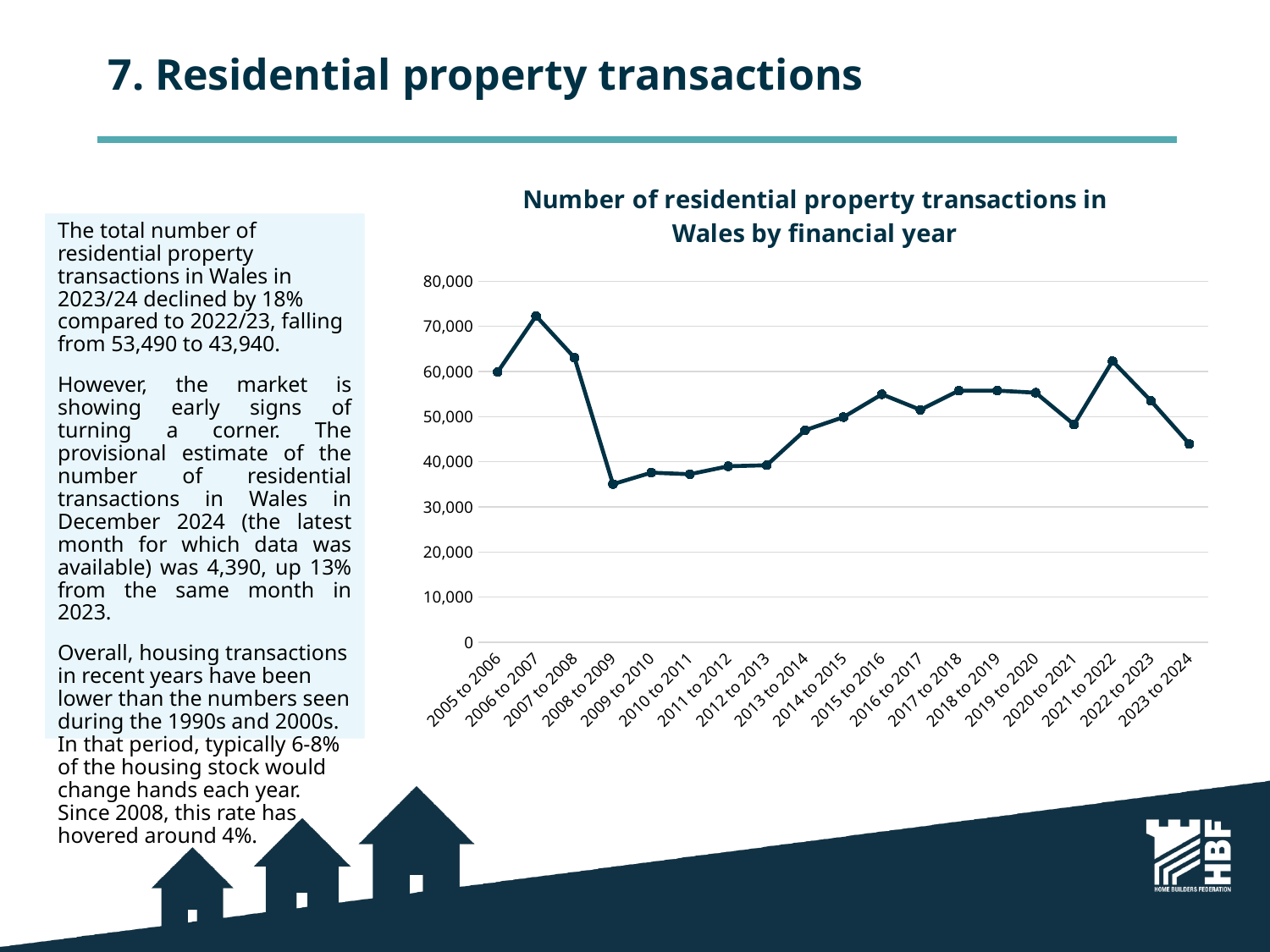
What is the title of the chart? Number of residential property transactions in Wales by financial year Is the value for 2008 to 2009 greater or less than 40,000? less Is the value for 2023 to 2024 greater or less than 50,000? less Is the value for 2006 to 2007 greater or less than 70,000? greater Which financial year has the highest number of residential property transactions? 2006 to 2007 Which is larger, the value for 2006 to 2007 or the value for 2021 to 2022? 2006 to 2007 Which financial year has the lowest number of residential property transactions? 2008 to 2009 Do the values rise or fall from 2021 to 2022 through 2023 to 2024? fall How many financial years are plotted on the chart? 19 What kind of chart is shown on the slide? line chart Which is larger, the value for 2022 to 2023 or the value for 2023 to 2024? 2022 to 2023